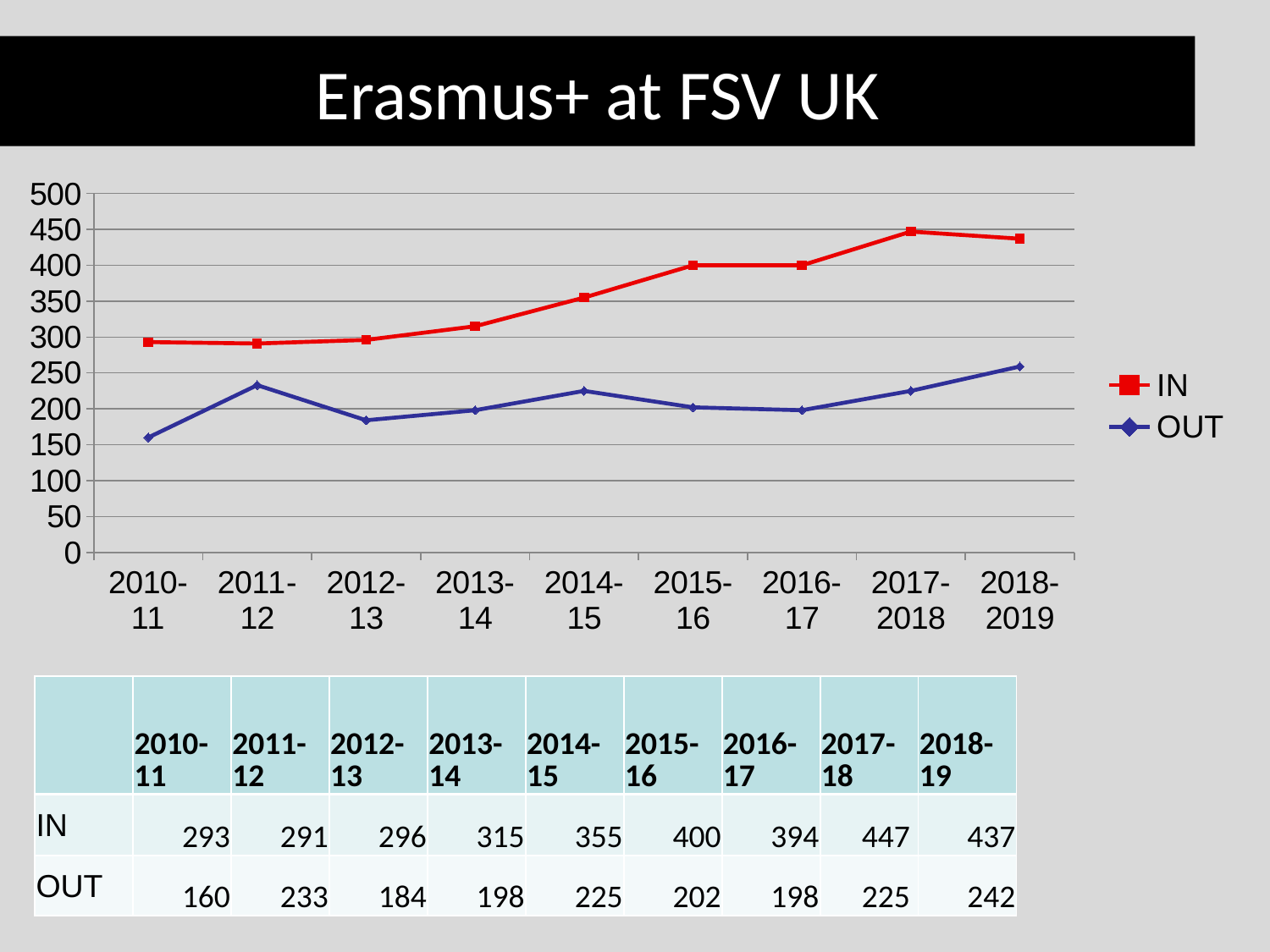
What kind of chart is shown on the slide? line chart In which year is the IN series at its highest? 2017-2018 In which year is the OUT series at its lowest? 2010-11 Is the IN value for 2010-11 greater or less than 250? greater What colour is the IN line in the chart? red In 2014-15, which is larger, IN or OUT? IN Does the IN series generally rise or fall from 2010-11 to 2017-2018? rise How many series does the legend list? 2 How many academic years are plotted along the x axis? 9 What is the OUT value for 2011-12? 233 What is the IN value for 2015-16? 400 What is the difference between IN and OUT in 2015-16? 198